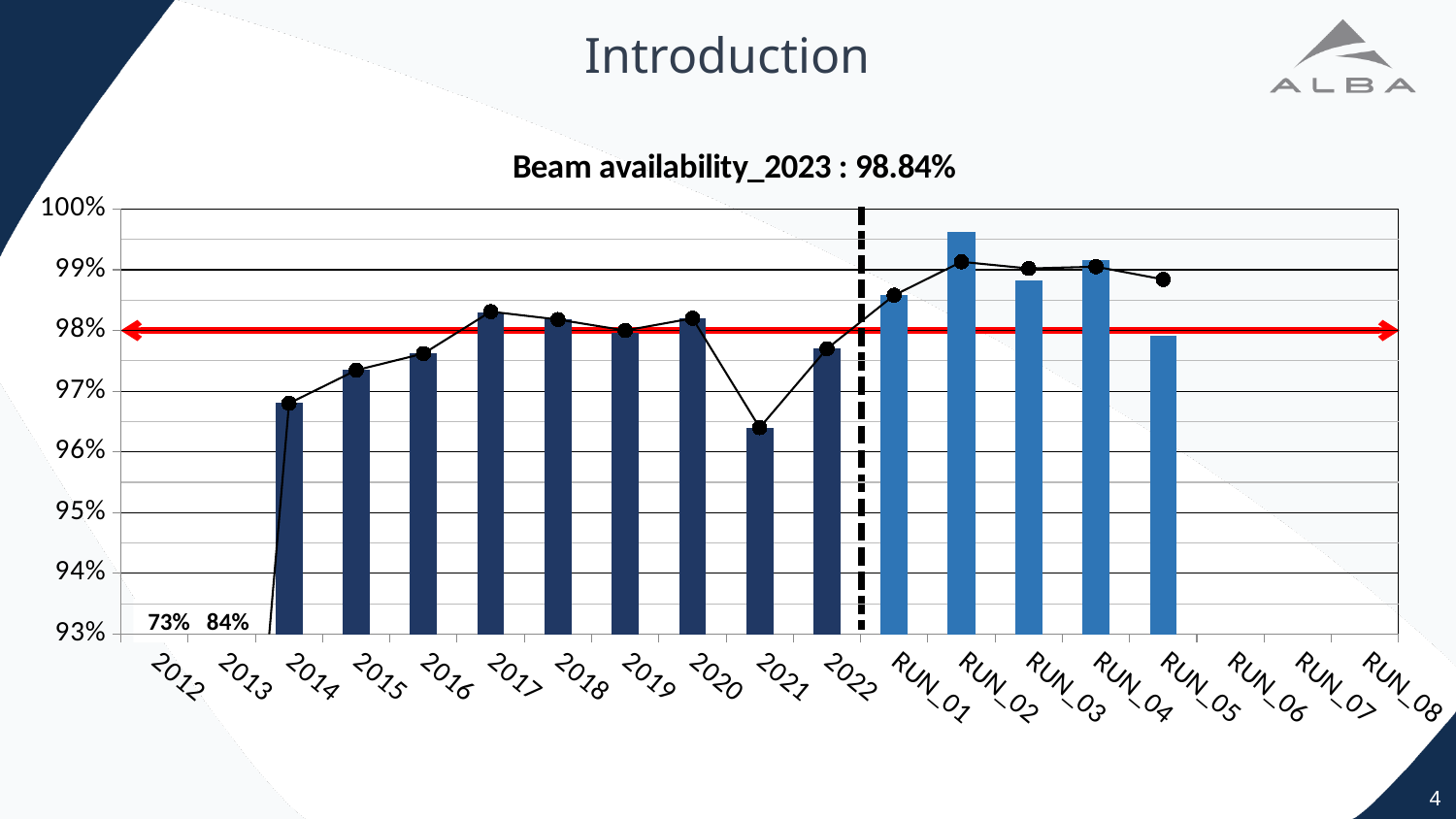
Which category has the lowest beam availability value? 2012 Do the bar values rise or fall from 2014 to 2017? rise What is the difference between the labelled values for 2013 and 2012? 11 percentage points Which is larger, the value for 2021 or the value for 2022? 2022 Is the value for RUN_02 greater or less than 99%? greater Which category has the tallest bar in the chart? RUN_02 What is the beam availability value shown for 2012? 73% How many RUN categories are listed on the x axis? 8 Is the value for 2017 greater or less than 98%? greater What beam availability value for 2023 is stated in the chart title? 98.84% Is the value for 2021 greater or less than 97%? less What is the beam availability value shown for 2013? 84%